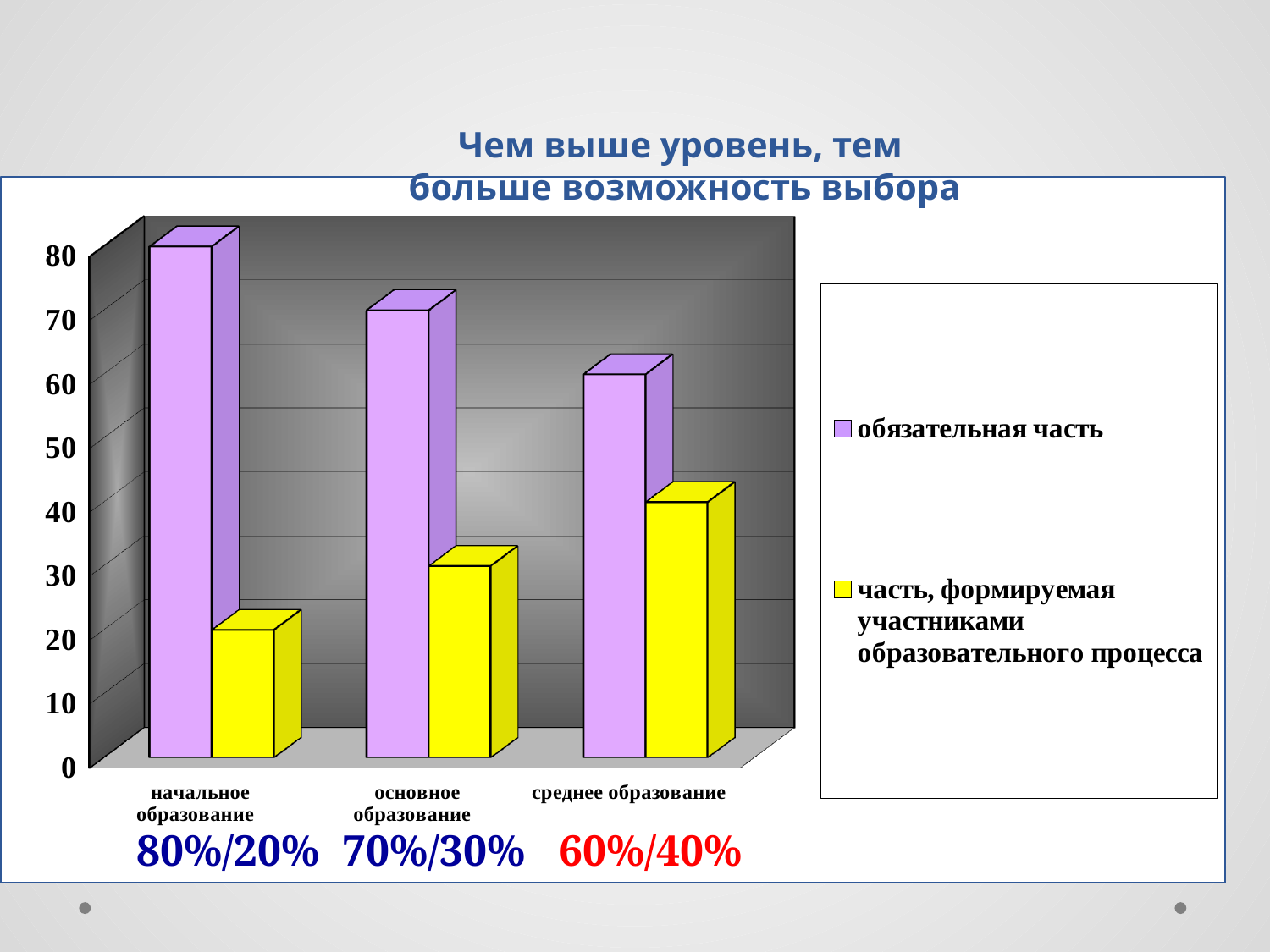
What type of chart is shown on the slide? bar chart How many series does the chart's legend list? 2 What is the value of обязательная часть for основное образование? 70% Which category has the lowest value for часть, формируемая участниками образовательного процесса? начальное образование What colour are the bars for обязательная часть? purple Which is larger for основное образование: обязательная часть or часть, формируемая участниками образовательного процесса? обязательная часть What is the value of обязательная часть for начальное образование? 80% Do the values of обязательная часть rise or fall from начальное образование to среднее образование? fall Which category has the highest value for обязательная часть? начальное образование How many categories are shown on the x axis of the chart? 3 What is the value of часть, формируемая участниками образовательного процесса for среднее образование? 40% What is the difference between обязательная часть and часть, формируемая участниками образовательного процесса for среднее образование? 20%